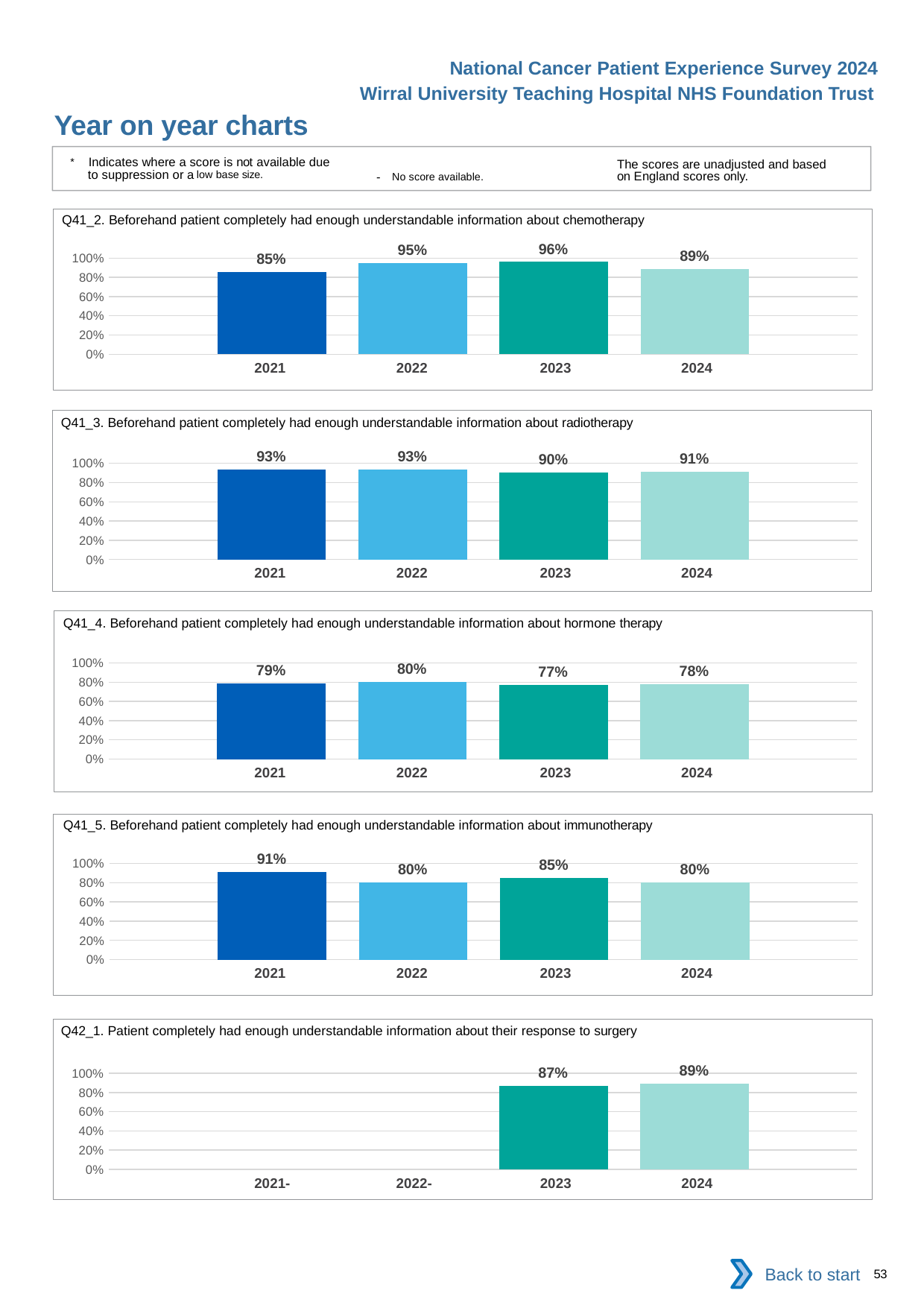
In the Q41_3 chart (radiotherapy), what is the value for 2024? 91% In the Q41_3 chart (radiotherapy), what is the difference between the 2021 value and the 2023 value? 3 percentage points In the Q41_5 chart (immunotherapy), what is the difference between the 2021 value and the 2022 value? 11 percentage points In the Q41_2 chart (chemotherapy), what is the value for 2023? 96% In the Q42_1 chart (response to surgery), how many years have a bar plotted? 2 In the Q41_5 chart (immunotherapy), what is the value for 2021? 91% What type of chart is the Q41_2 chart (chemotherapy)? Bar chart In the Q41_5 chart (immunotherapy), which is larger, the value for 2021 or the value for 2023? 2021 In the Q42_1 chart (response to surgery), what is the value for 2024? 89% In the Q41_4 chart (hormone therapy), which year has the highest value? 2022 In the Q41_4 chart (hormone therapy), what is the value for 2023? 77% In the Q41_2 chart (chemotherapy), which year has the lowest value? 2021